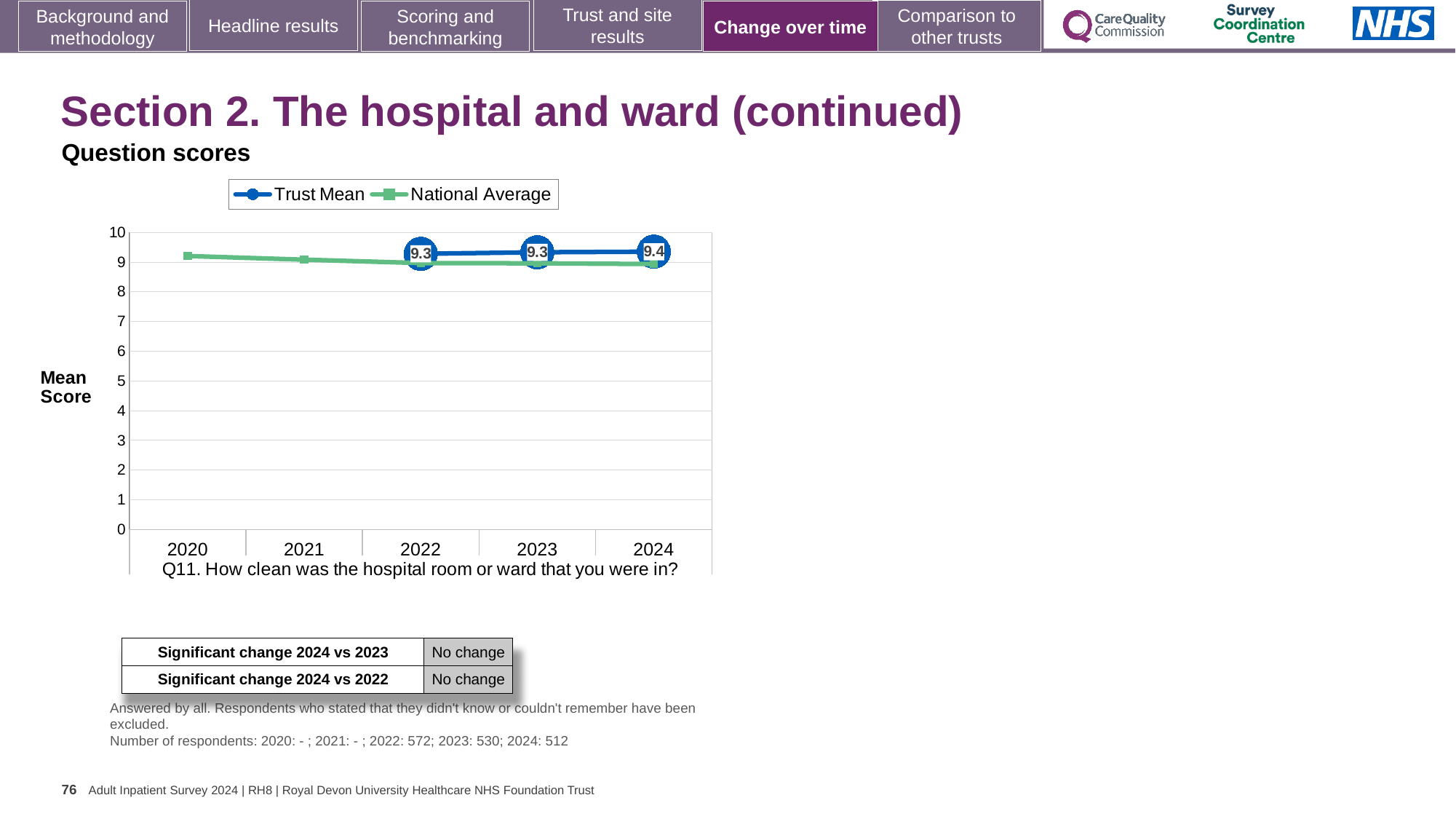
In which year is the Trust Mean highest? 2024 What is the Trust Mean value for 2022? 9.3 What is the Trust Mean value for 2023? 9.3 Does the National Average rise or fall from 2020 to 2024? fall What kind of chart is shown on the slide? line chart What is the difference between the Trust Mean in 2024 and in 2022? 0.1 How many years are shown on the x axis? 5 How many series does the legend list? 2 What is the Trust Mean value for 2024? 9.4 Which is larger, the Trust Mean in 2024 or the Trust Mean in 2022? 2024 In 2024, which series has the higher value, Trust Mean or National Average? Trust Mean Is the National Average value for 2020 greater or less than 8? greater